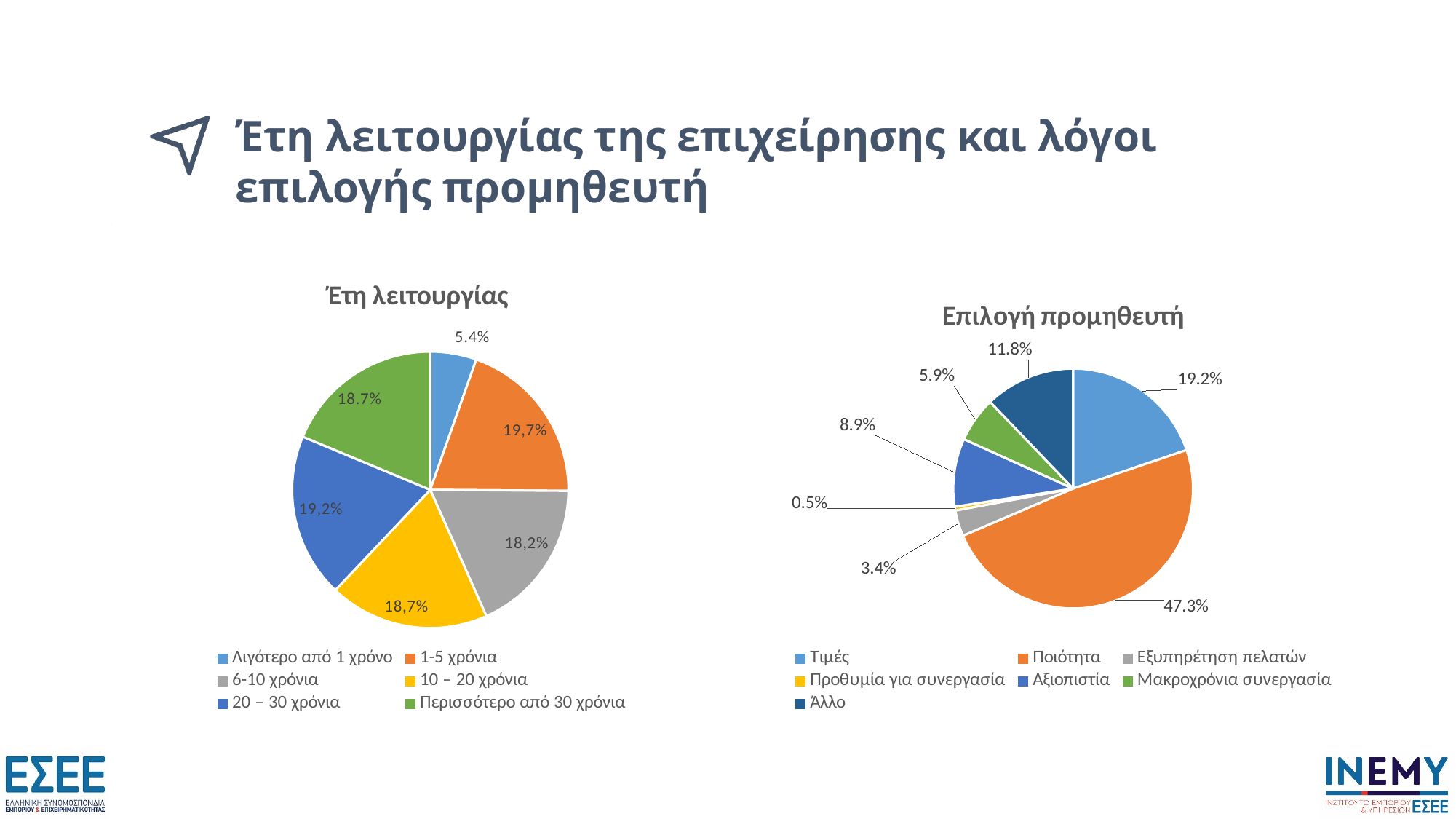
What type of chart is the 'Έτη λειτουργίας' chart? Pie chart How many categories does the legend of the 'Έτη λειτουργίας' chart list? 6 In the 'Επιλογή προμηθευτή' chart, what is the share for 'Ποιότητα'? 47.3% In the 'Έτη λειτουργίας' chart, which category has the smallest share? Λιγότερο από 1 χρόνο In the 'Έτη λειτουργίας' chart, which category has the largest share? 1-5 χρόνια In the 'Έτη λειτουργίας' chart, what is the share for 'Λιγότερο από 1 χρόνο'? 5.4% In the 'Επιλογή προμηθευτή' chart, what is the share for 'Αξιοπιστία'? 8.9% In the 'Επιλογή προμηθευτή' chart, which is larger: 'Άλλο' or 'Μακροχρόνια συνεργασία'? Άλλο In the 'Επιλογή προμηθευτή' chart, which category has the smallest share? Προθυμία για συνεργασία In the 'Έτη λειτουργίας' chart, what is the share for '1-5 χρόνια'? 19,7% In the 'Επιλογή προμηθευτή' chart, what is the difference between the shares of 'Ποιότητα' and 'Τιμές'? 28.1% How many categories does the legend of the 'Επιλογή προμηθευτή' chart list? 7